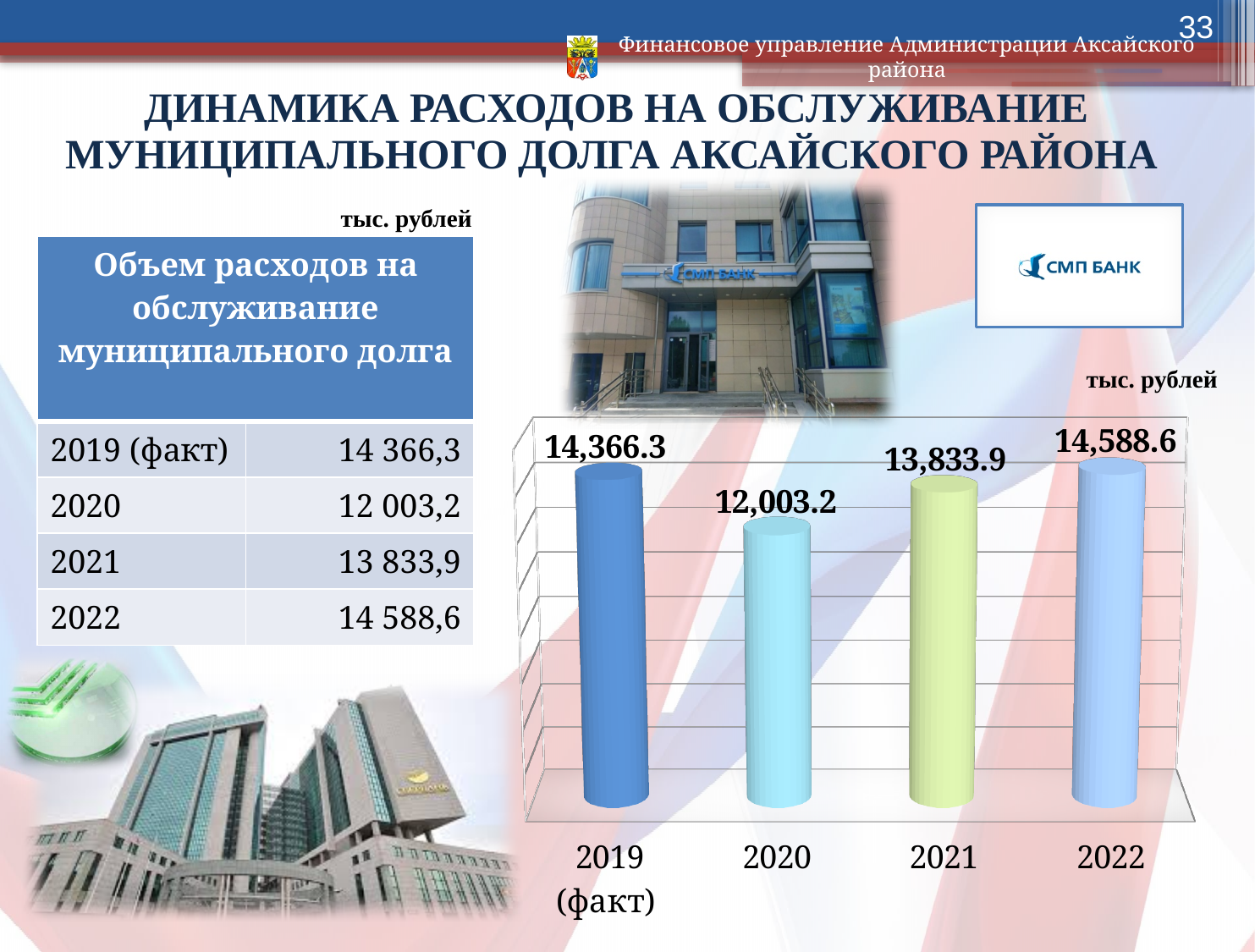
Do the values rise or fall from 2020 to 2022? rise What is the value for 2021 in the chart? 13,833.9 Which year has the lowest value in the chart? 2020 What is the difference between the values for 2019 (факт) and 2020? 2,363.1 What is the value for 2019 (факт) in the chart? 14,366.3 What kind of chart is shown on the slide? bar chart What is the difference between the values for 2022 and 2021? 754.7 What is the value for 2022 in the chart? 14,588.6 What is the value for 2020 in the chart? 12,003.2 Which is larger, the value for 2019 (факт) or the value for 2021? 2019 (факт) How many years are shown in the chart? 4 Which year has the highest value in the chart? 2022